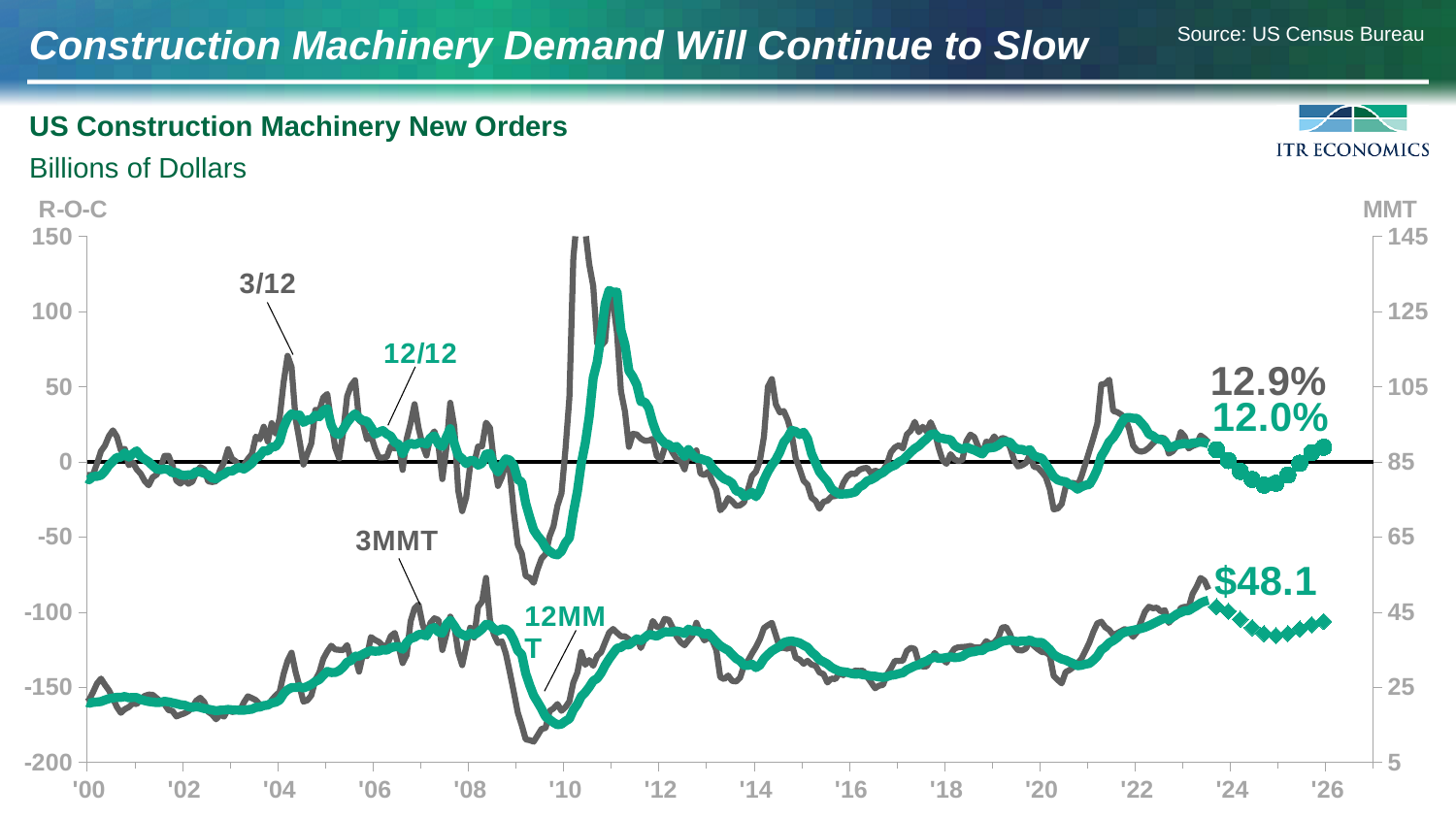
How many data series are labeled on the chart? 4 Is the 12MMT series at its 2009 trough greater or less than 25 on the MMT axis? less Which is larger, the labeled 3/12 value of 12.9% or the labeled 12/12 value of 12.0%? 3/12 (12.9%) What is the difference between the labeled 3/12 value (12.9%) and the labeled 12/12 value (12.0%)? 0.9 percentage points What is the latest labeled value of the 3/12 rate-of-change series? 12.9% What kind of chart is shown on the slide? line chart In what units are the values on the chart expressed? Billions of Dollars What is the title of the chart on the slide? US Construction Machinery New Orders Is the peak of the 12/12 series around 2011 greater or less than 100 on the R-O-C axis? greater What is the latest labeled value of the 12MMT series? $48.1 Does the 12MMT series rise or fall between 2020 and 2023? rise What is the latest labeled value of the 12/12 rate-of-change series? 12.0%